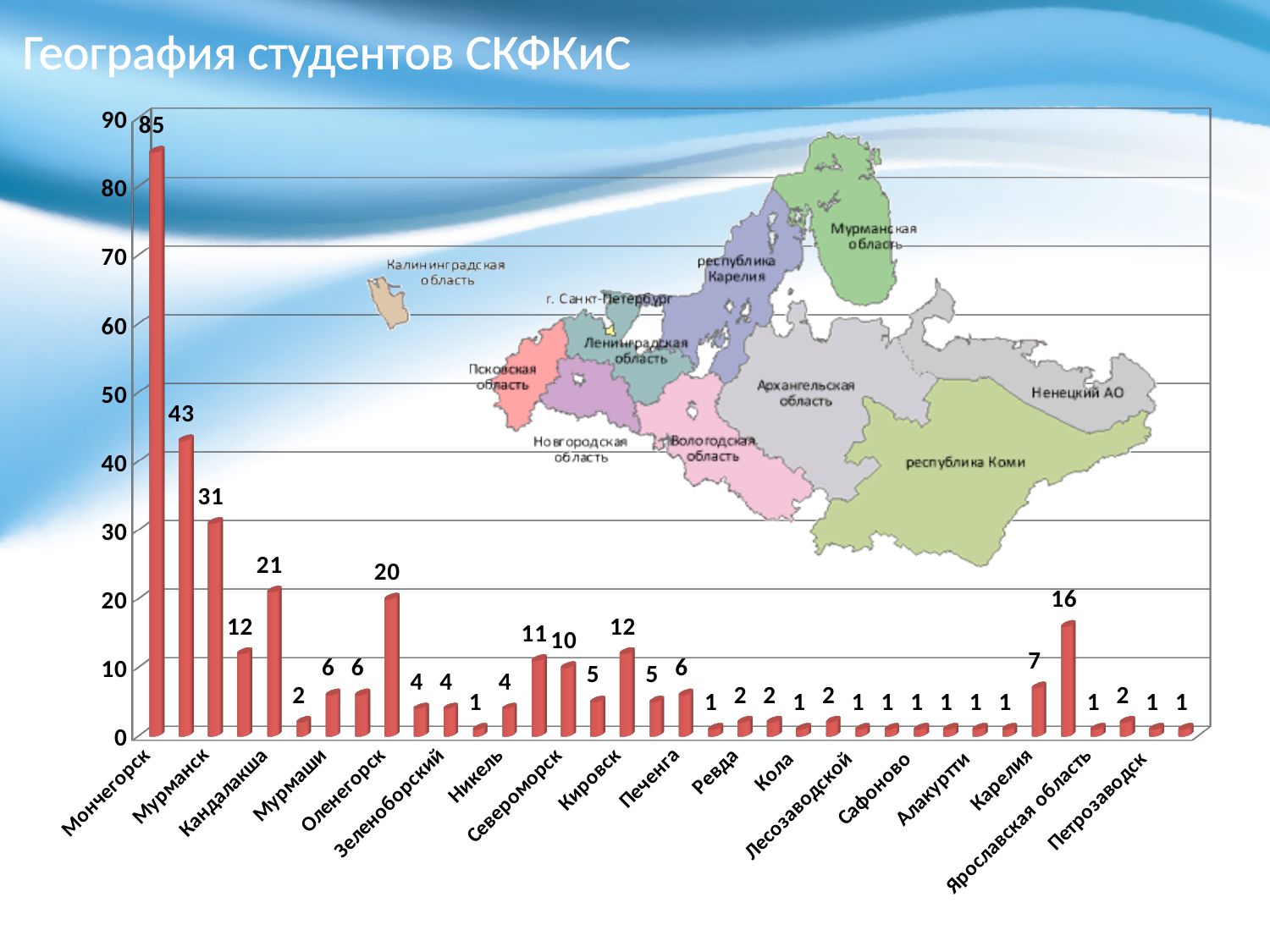
What is the maximum value shown on the vertical axis? 90 Is the value for Мончегорск greater or less than 80? greater What is the value for Мончегорск? 85 What type of chart is shown on the slide? bar chart Which category has the highest value? Мончегорск What is the lowest value shown on the chart? 1 What is the difference between the value for Мончегорск and the value for Оленегорск? 65 What is the value for Оленегорск? 20 Which is larger, the value for Мончегорск or the value for Оленегорск? Мончегорск What is the title of the slide? География студентов СКФКиС What is the highest value shown on the chart? 85 What is the value for Карелия? 7